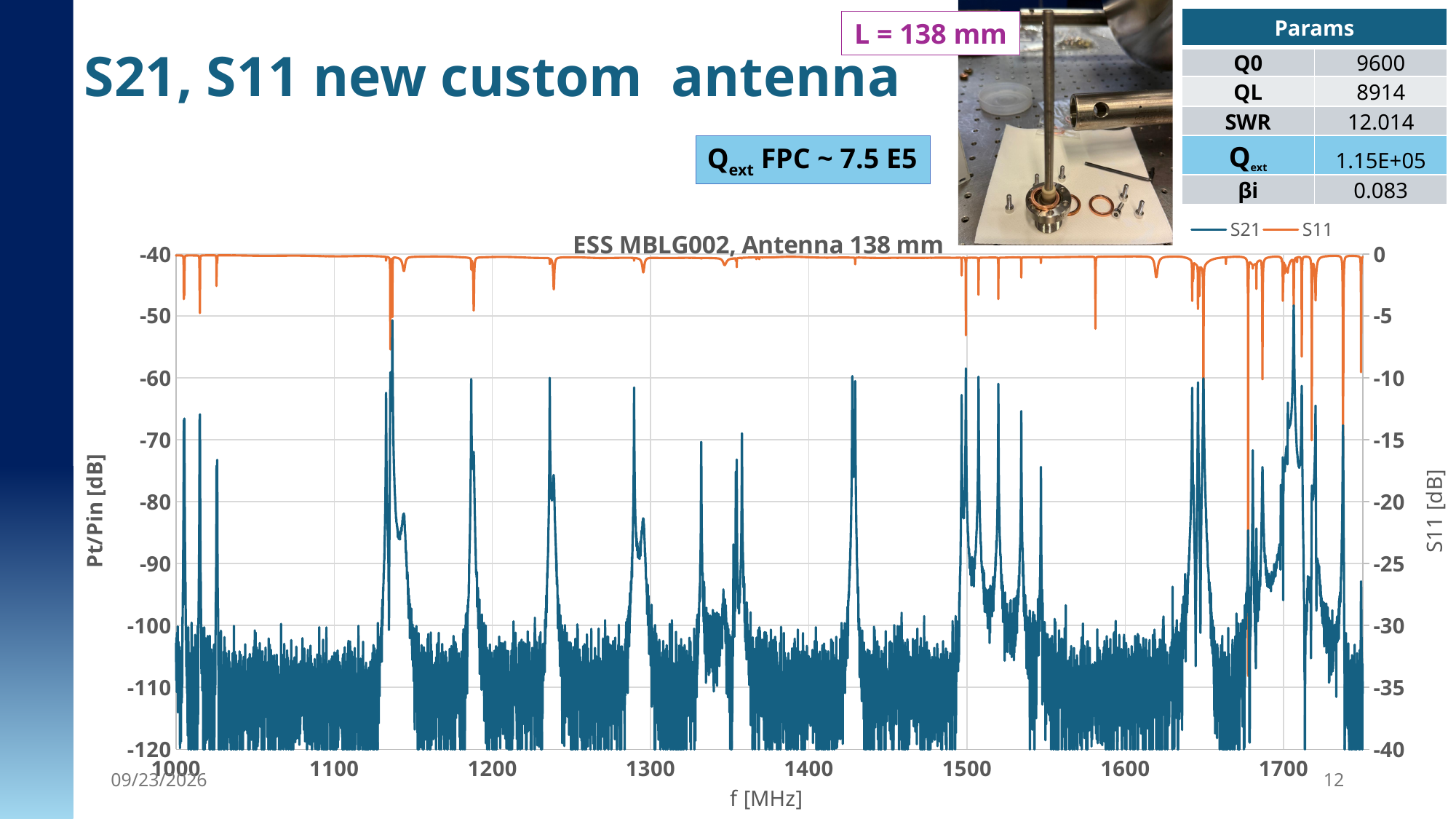
Is the S21 peak near 1240 MHz greater or less than -80 dB on the left axis? greater How many series does the chart legend list? 2 Is the S21 peak near 1425 MHz greater or less than -70 dB on the left axis? greater Is the S11 dip near 1680 MHz greater or less than -10 dB on the right axis? less Which series is drawn in orange in the chart? S11 What kind of chart is shown on the slide? line chart Which series has the larger value at 1300 MHz, S21 (left axis) or S11 (right axis)? S11 What is the title of the chart? ESS MBLG002, Antenna 138 mm